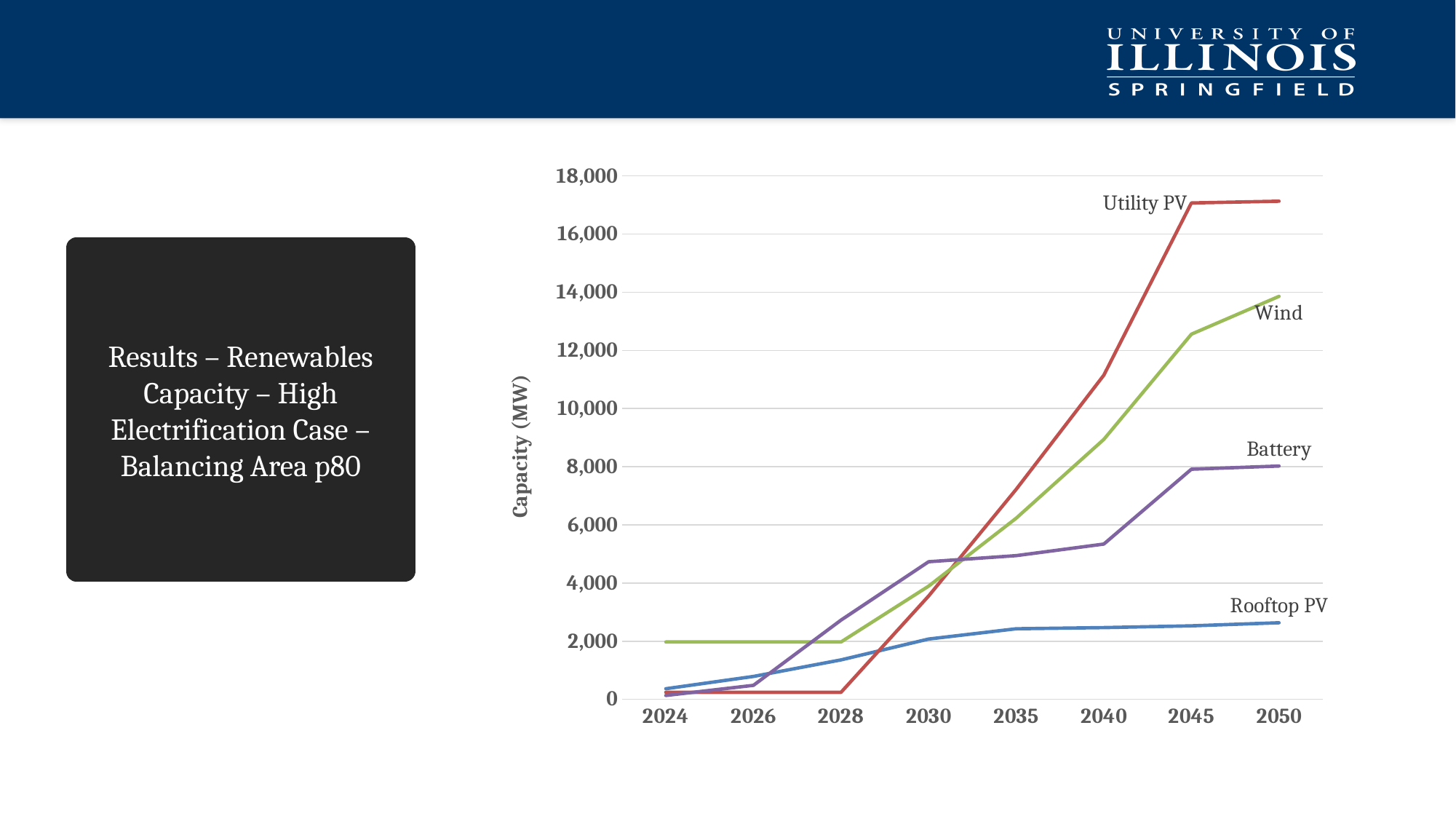
Is the value for Battery in 2050 greater or less than 10,000? less How many years are marked along the x axis of the chart? 8 Is the value for Rooftop PV in 2050 greater or less than 4,000? less Is the value for Wind in 2040 greater or less than 10,000? less What is the title of the vertical axis of the chart? Capacity (MW) What kind of chart is shown on the slide? line chart Does the Utility PV line rise or fall between 2028 and 2045? rise In 2024, which is larger: the value for Wind or the value for Rooftop PV? Wind Which series has the highest capacity in 2050? Utility PV Which series has the lowest capacity in 2050? Rooftop PV How many series are plotted on the chart? 4